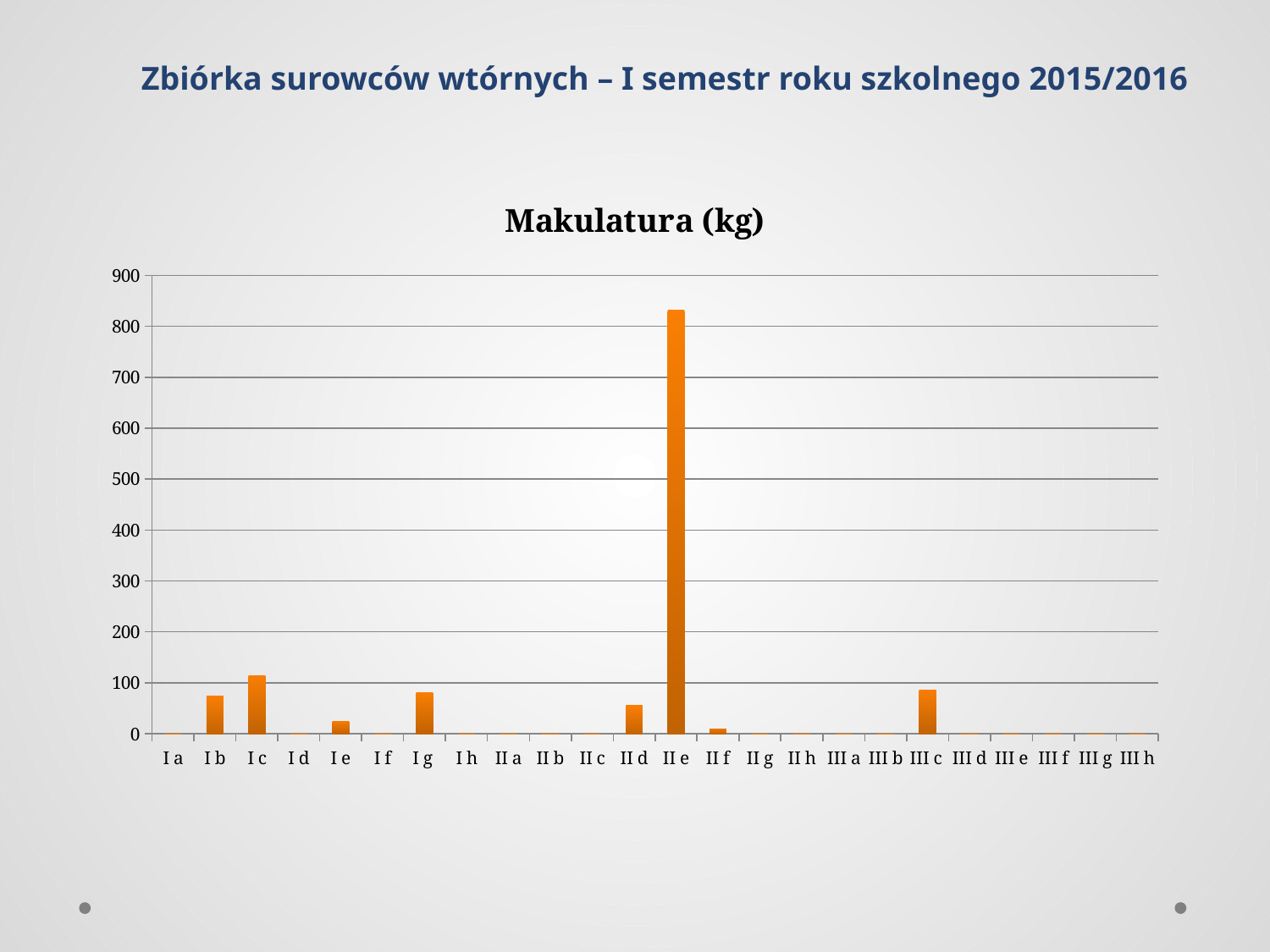
Is the value for I c greater or less than 100? greater Is the value for II e greater or less than 800? greater Which is larger, the value for I c or the value for I b? I c What is the title of the chart? Makulatura (kg) Which category has the highest value in the chart? II e Is the value for I b greater or less than 100? less Which is larger, the value for I g or the value for I e? I g What kind of chart is shown on the slide? bar chart How many categories are shown on the x axis of the chart? 24 Which is larger, the value for II e or the value for III c? II e